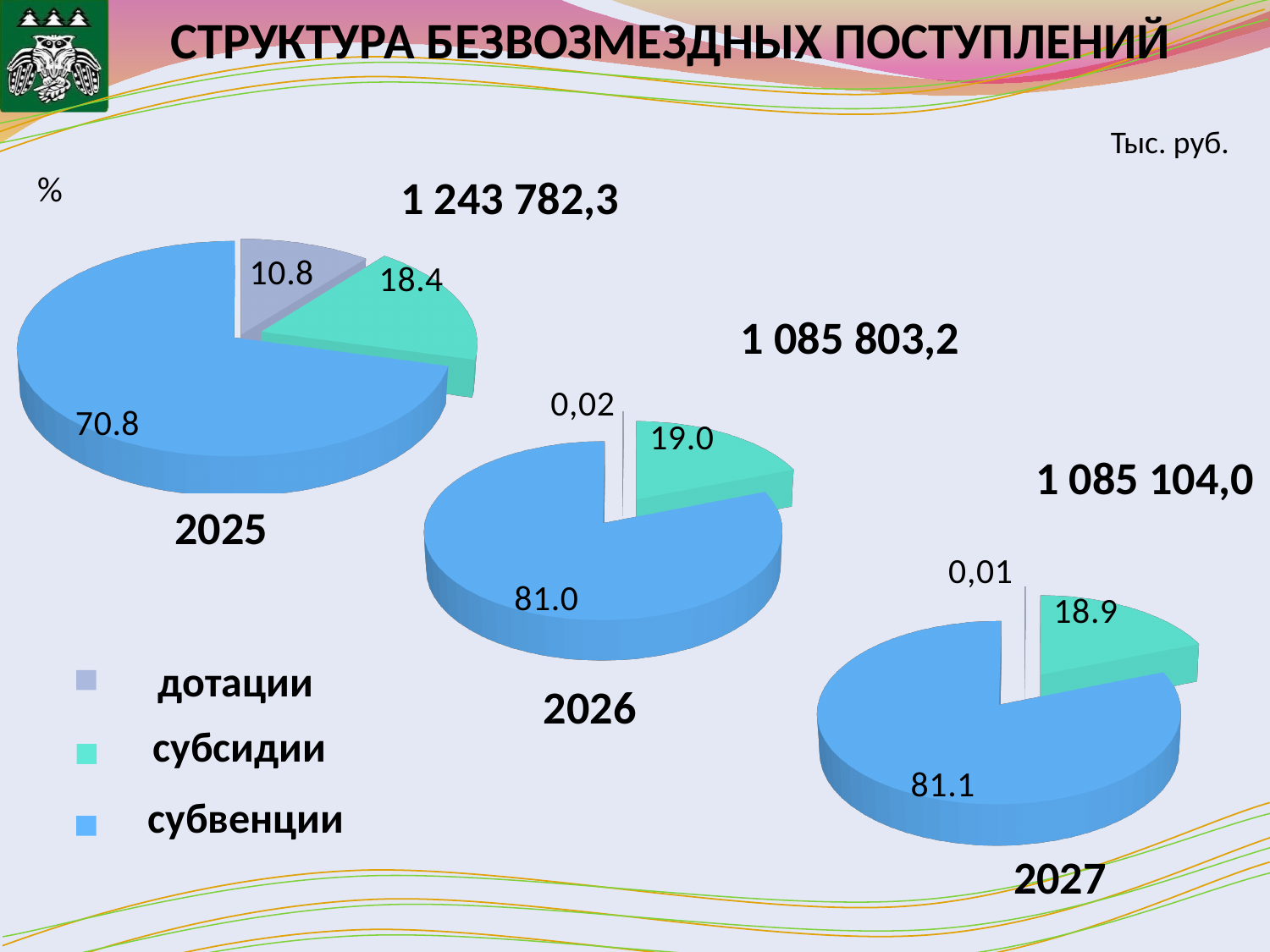
What total amount (тыс. руб.) is shown above the 2026 pie chart? 1 085 803,2 In the 2025 pie chart, what is the share for дотации? 10.8 In the 2027 pie chart, which is larger: the share for субсидии or the share for субвенции? субвенции How many pie charts are on the slide? 3 In the 2027 pie chart, what is the share for субвенции? 81.1 In the 2026 pie chart, which category has the smallest share? дотации In the 2027 pie chart, what is the share for дотации? 0,01 How many categories does the legend list? 3 In the 2025 pie chart, which category has the largest share? субвенции In the 2025 pie chart, what is the share for субвенции? 70.8 In the 2025 pie chart, what is the difference between the shares for субсидии and дотации? 7.6 In the 2026 pie chart, what is the share for субсидии? 19.0